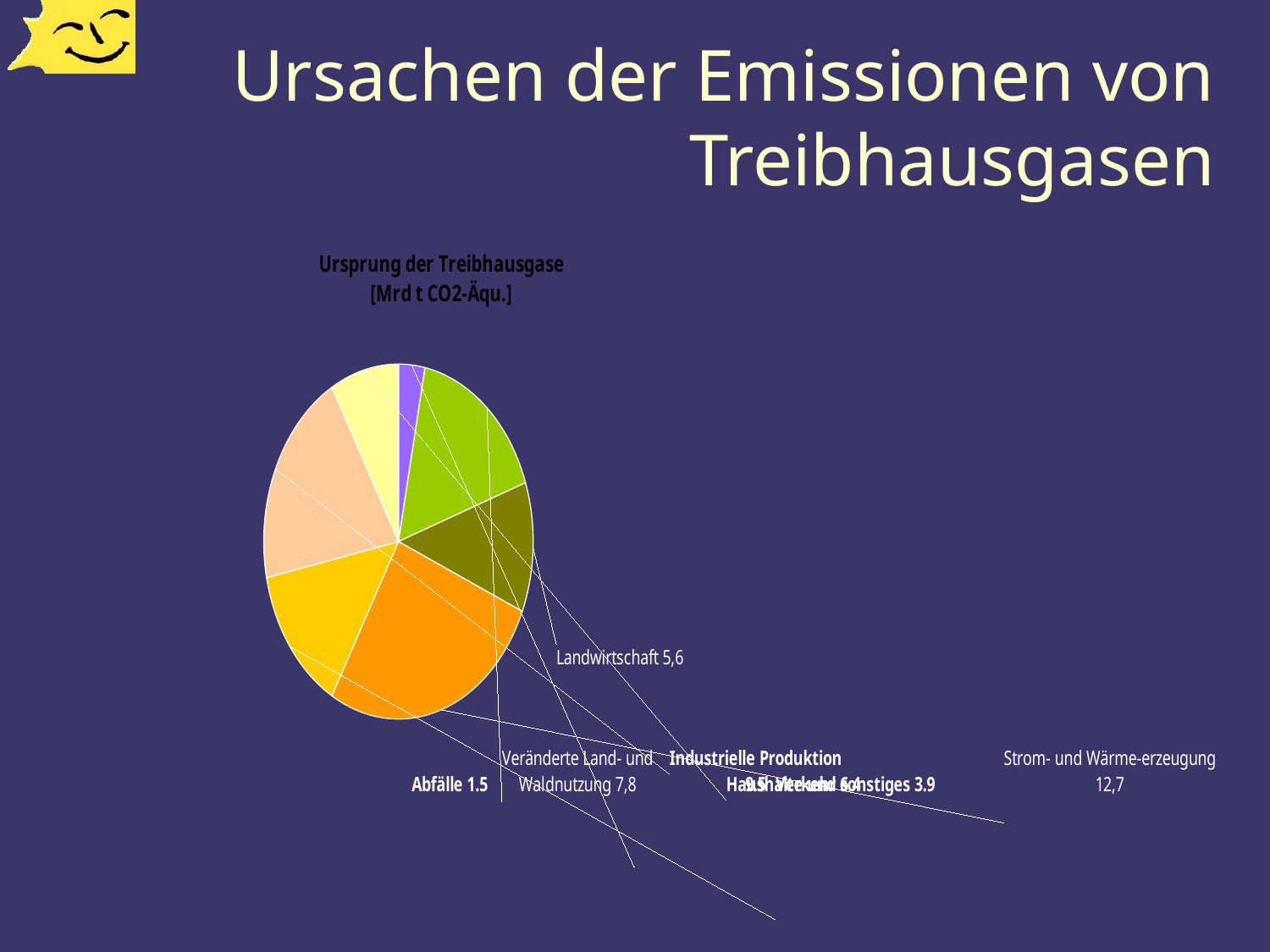
What is the value for Strom- und Wärmeerzeugung? 12,7 Which category has the smallest slice of the pie? Abfälle What is the value for Haushalte und Sonstiges? 3.9 What kind of chart is shown on the slide? pie chart Which is larger, Landwirtschaft or Veränderte Land- und Waldnutzung? Veränderte Land- und Waldnutzung What is the difference between Strom- und Wärmeerzeugung and Landwirtschaft? 7,1 What is the title of the chart? Ursprung der Treibhausgase [Mrd t CO2-Äqu.] What is the value for Abfälle? 1.5 Which category has the largest slice of the pie? Strom- und Wärmeerzeugung What is the value for Veränderte Land- und Waldnutzung? 7,8 How many slices does the pie chart have? 7 What is the value for Landwirtschaft? 5,6